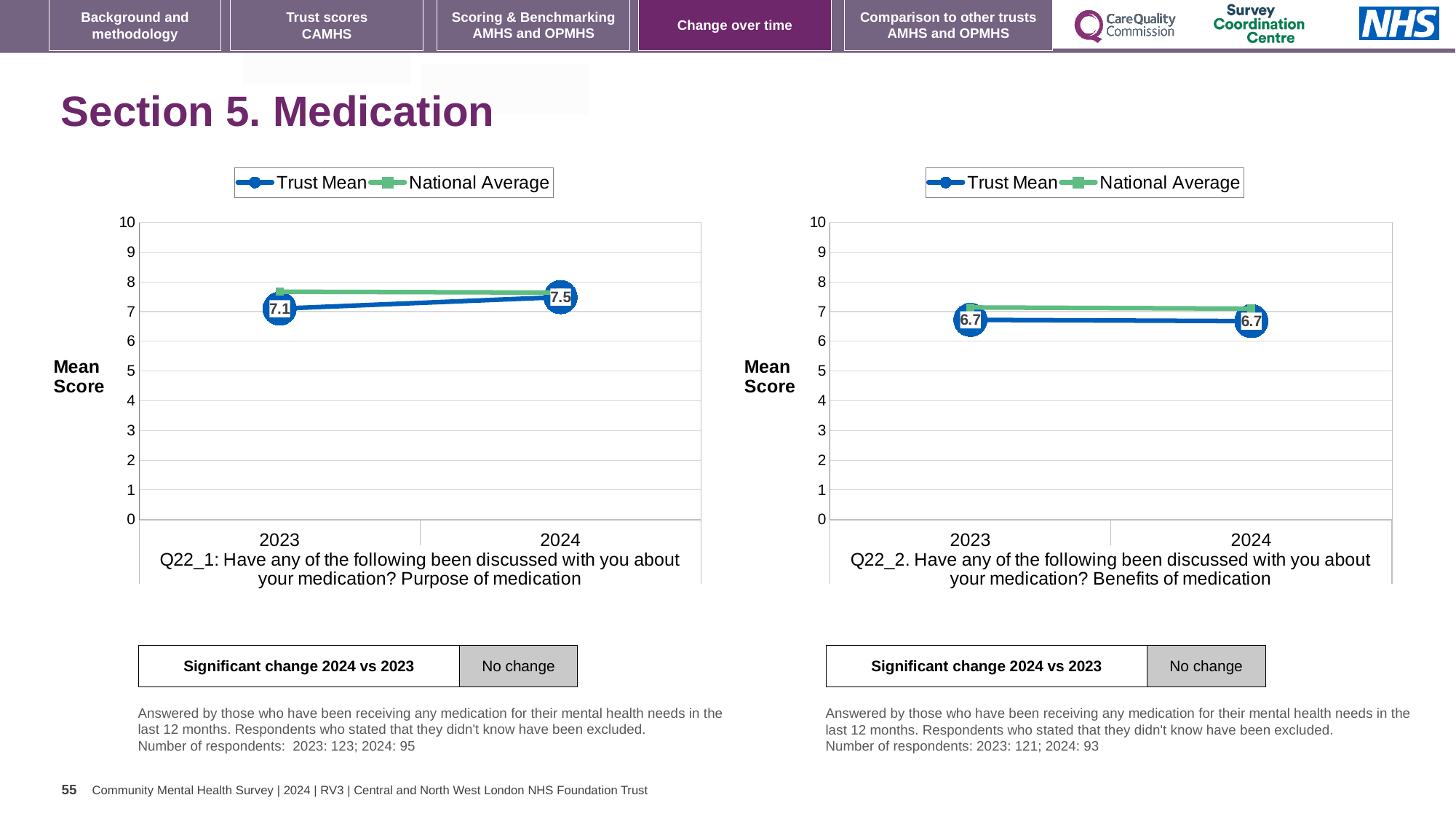
In the left chart (Q22_1: Purpose of medication), by how much did the Trust Mean change from 2023 to 2024? 0.4 In the right chart (Q22_2: Benefits of medication), which is higher in 2023, the Trust Mean or the National Average? National Average What kind of chart is the left chart (Q22_1: Purpose of medication)? line chart In the right chart (Q22_2: Benefits of medication), does the Trust Mean rise, fall or stay the same from 2023 to 2024? stays the same In the left chart (Q22_1: Purpose of medication), does the Trust Mean rise or fall from 2023 to 2024? rise How many years are shown on the x axis of the left chart (Q22_1: Purpose of medication)? 2 In the left chart (Q22_1: Purpose of medication), which is higher in 2023, the Trust Mean or the National Average? National Average In the left chart (Q22_1: Purpose of medication), what is the Trust Mean for 2024? 7.5 How many series does the legend of the right chart (Q22_2: Benefits of medication) list? 2 In the left chart (Q22_1: Purpose of medication), what is the Trust Mean for 2023? 7.1 In the left chart (Q22_1: Purpose of medication), is the National Average for 2023 greater or less than 7? greater In the right chart (Q22_2: Benefits of medication), what is the Trust Mean for 2024? 6.7